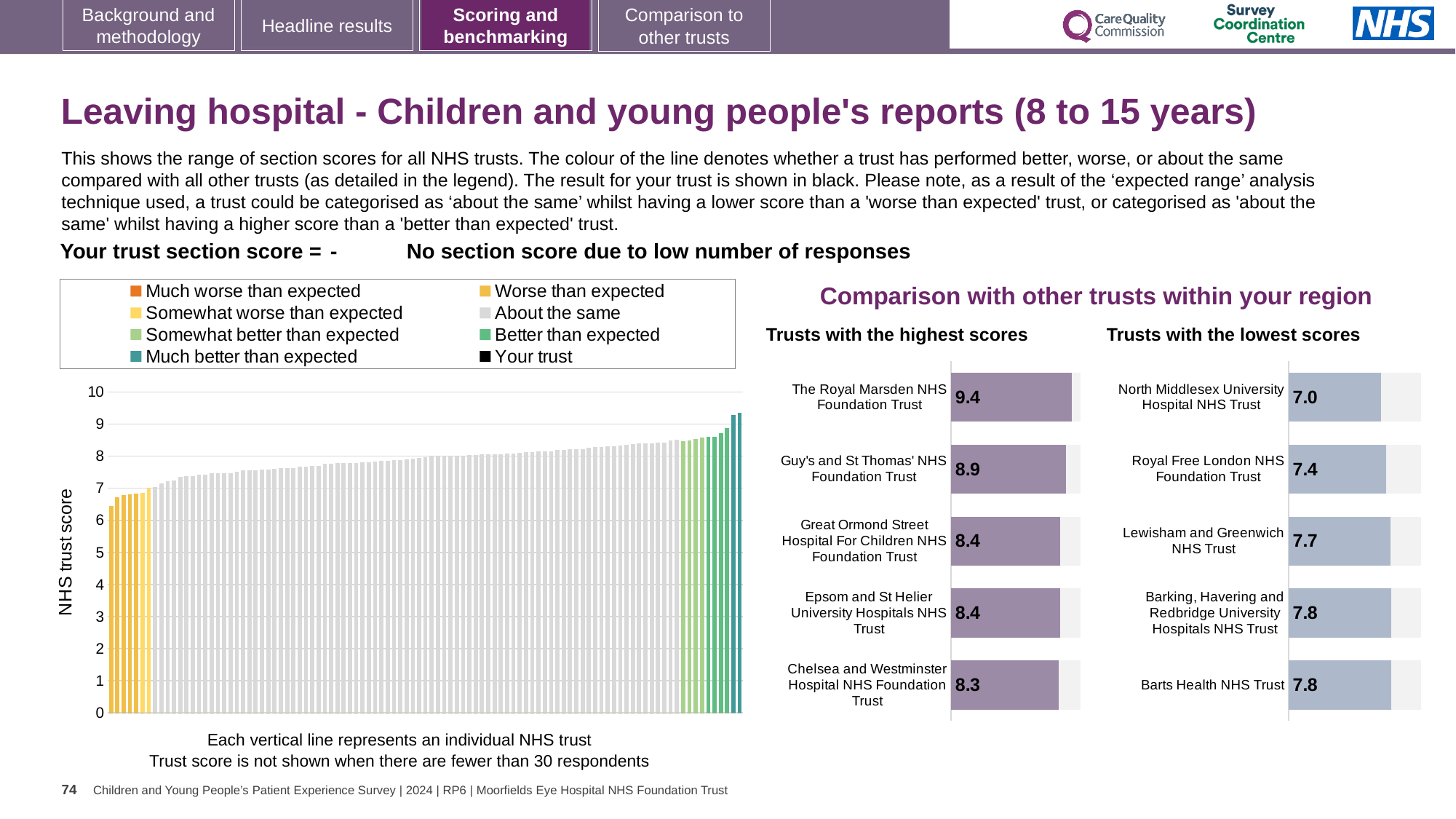
What kind of chart is the large chart on the left with the 'NHS trust score' axis? Bar chart How many trusts are shown in the 'Trusts with the highest scores' chart? 5 In the large 'NHS trust score' chart on the left, do the bar heights rise or fall from left to right? Rise In the 'Trusts with the lowest scores' chart, which trust has the lowest score? North Middlesex University Hospital NHS Trust In the 'Trusts with the lowest scores' chart, which has the larger score: Royal Free London NHS Foundation Trust or North Middlesex University Hospital NHS Trust? Royal Free London NHS Foundation Trust How many entries does the legend above the 'NHS trust score' chart list? 8 In the 'Trusts with the highest scores' chart, what is the difference between the scores of The Royal Marsden NHS Foundation Trust and Guy's and St Thomas' NHS Foundation Trust? 0.5 In the 'Trusts with the lowest scores' chart, what is the score for Lewisham and Greenwich NHS Trust? 7.7 In the 'Trusts with the highest scores' chart, which trust has the highest score? The Royal Marsden NHS Foundation Trust In the 'Trusts with the lowest scores' chart, what is the score for North Middlesex University Hospital NHS Trust? 7.0 In the 'Trusts with the highest scores' chart, what is the score for The Royal Marsden NHS Foundation Trust? 9.4 In the 'Trusts with the highest scores' chart, what is the score for Chelsea and Westminster Hospital NHS Foundation Trust? 8.3